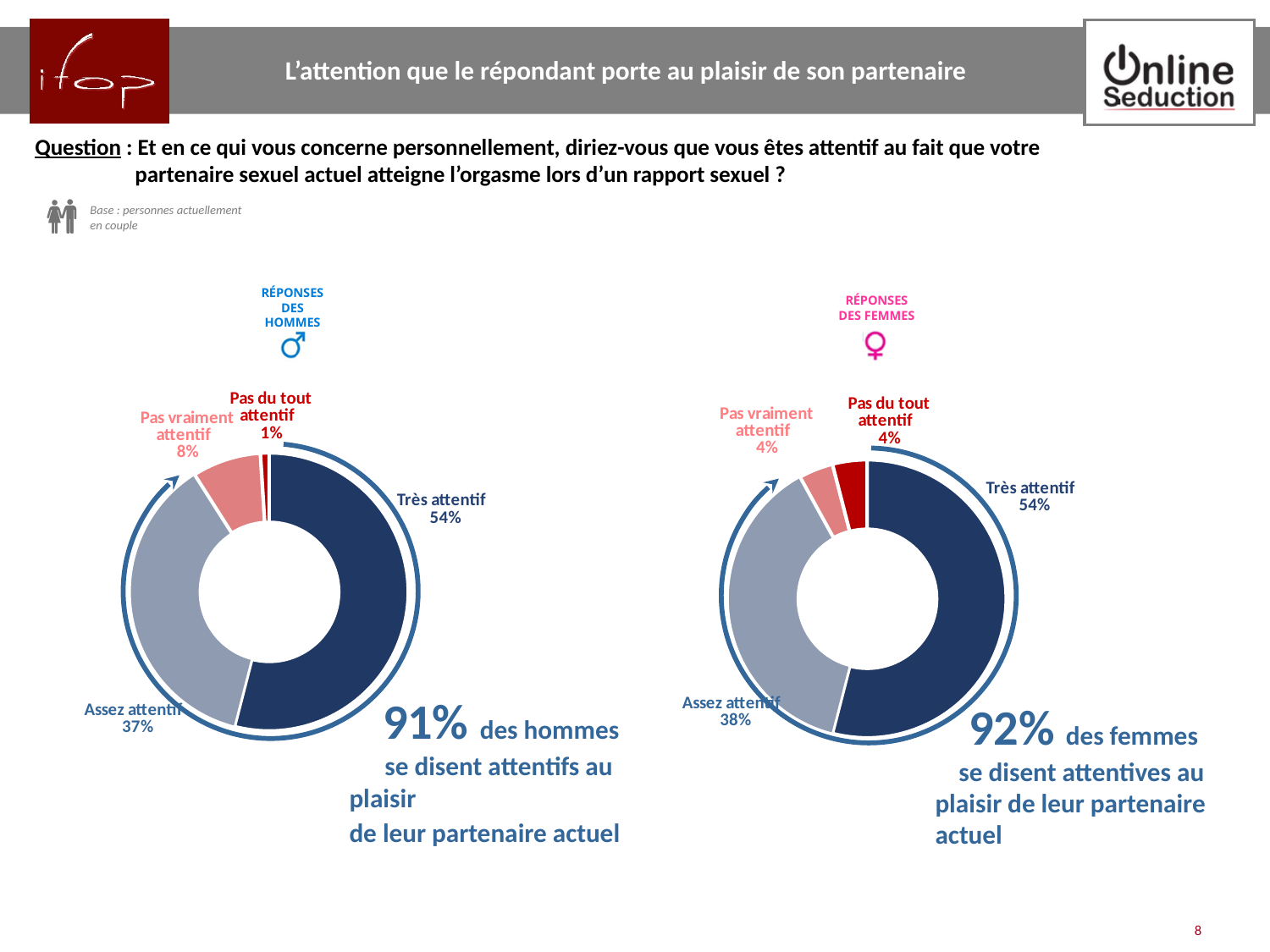
In the 'Réponses des femmes' chart on the right, what percentage of women answered 'Assez attentif'? 38% In the 'Réponses des femmes' chart on the right, what is the difference between the 'Très attentif' and 'Assez attentif' shares? 16 percentage points Which is larger: the 'Pas vraiment attentif' share in the 'Réponses des hommes' chart or in the 'Réponses des femmes' chart? Réponses des hommes In the 'Réponses des femmes' chart on the right, what percentage of women answered 'Pas vraiment attentif'? 4% In the 'Réponses des hommes' chart on the left, what percentage of men answered 'Très attentif'? 54% In the 'Réponses des hommes' chart on the left, what is the difference between the 'Très attentif' and 'Assez attentif' shares? 17 percentage points In the 'Réponses des hommes' chart on the left, which response category has the largest share? Très attentif In the 'Réponses des femmes' chart on the right, which response category has the largest share? Très attentif In the 'Réponses des hommes' chart on the left, what percentage of men answered 'Pas du tout attentif'? 1% How many response categories are shown in the 'Réponses des femmes' chart on the right? 4 What kind of chart is used for the 'Réponses des hommes' chart on the left? Donut (pie) chart In the 'Réponses des hommes' chart on the left, which response category has the smallest share? Pas du tout attentif